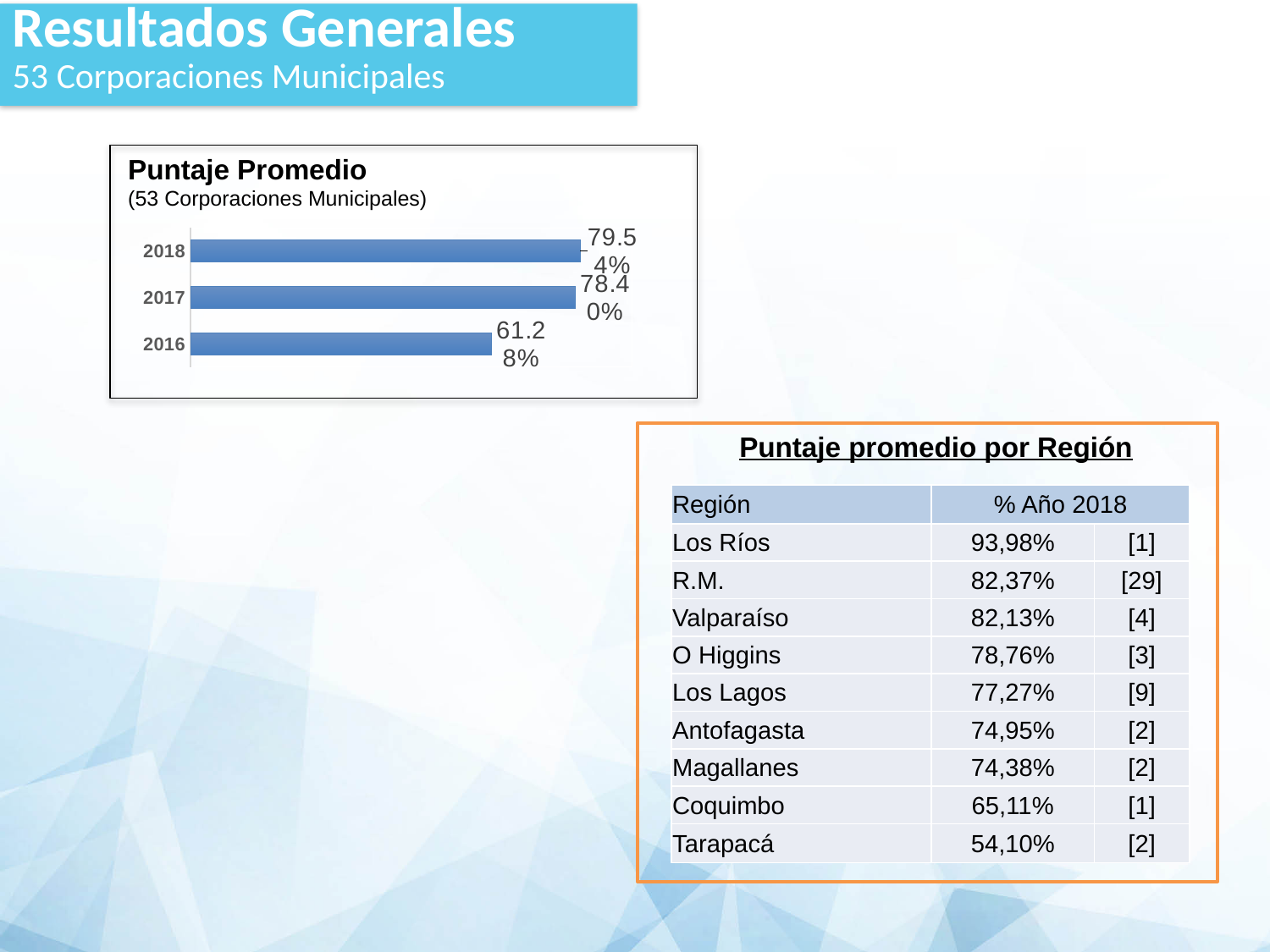
What is the value for 2016 in the Puntaje Promedio chart? 61.28% Which year has the highest value in the Puntaje Promedio chart? 2018 What is the difference between the 2018 and 2016 values in the Puntaje Promedio chart? 18.26% What is the value for 2018 in the Puntaje Promedio chart? 79.54% Which year has the lowest value in the Puntaje Promedio chart? 2016 What kind of chart is the Puntaje Promedio chart? Bar chart What is the difference between the 2017 and 2016 values in the Puntaje Promedio chart? 17.12% How many years are shown in the Puntaje Promedio chart? 3 What is the value for 2017 in the Puntaje Promedio chart? 78.40% What is the subtitle shown under the title of the Puntaje Promedio chart? (53 Corporaciones Municipales) Do the values in the Puntaje Promedio chart increase or decrease from 2016 to 2018? Increase In the Puntaje Promedio chart, which is larger, the value for 2017 or the value for 2016? 2017